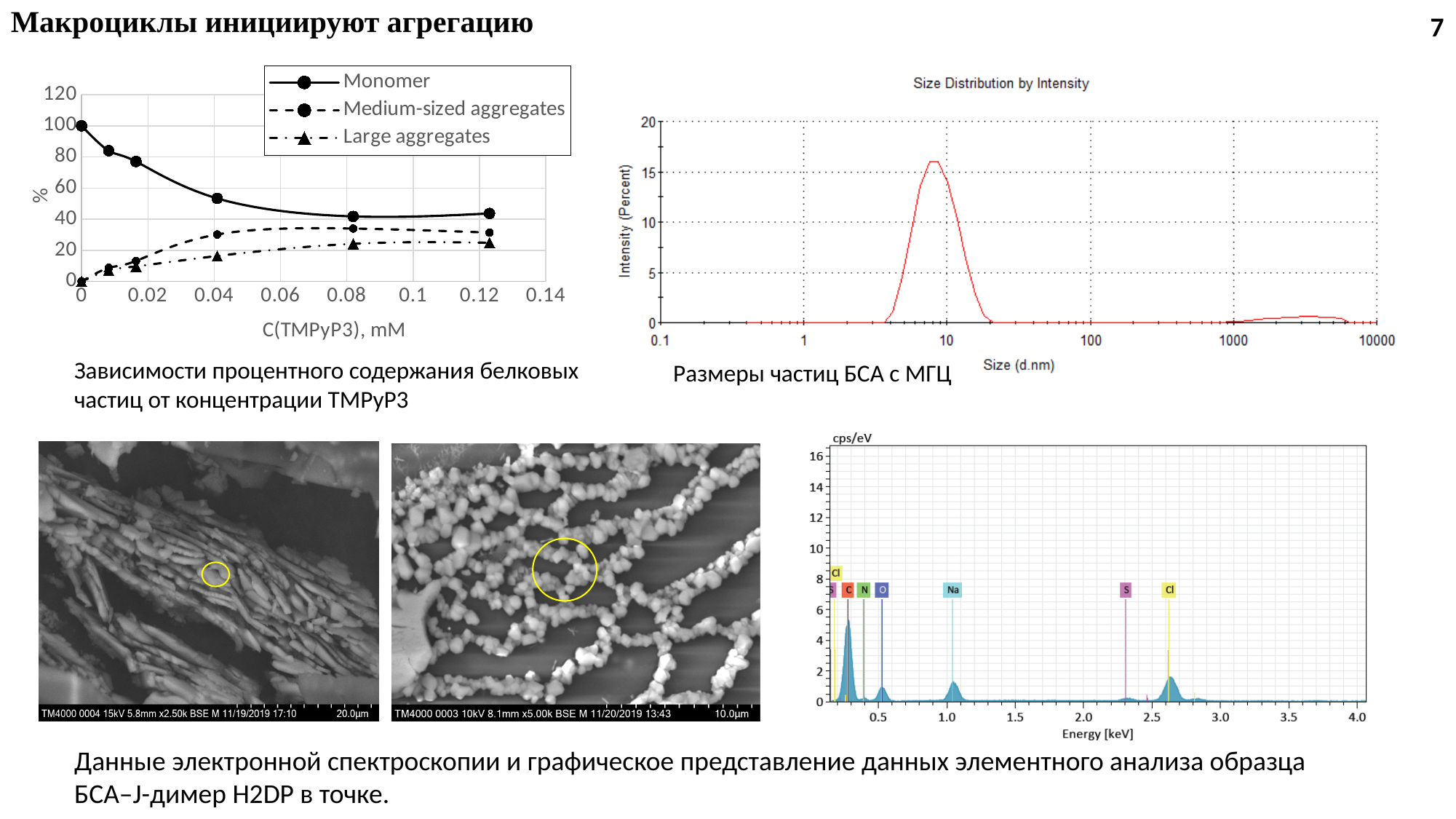
In the top-left chart, which series has the lowest value at 0.04 mM? Large aggregates In the top-left chart, does the Monomer series rise or fall as C(TMPyP3) increases from 0 to 0.08 mM? fall In the top-left chart, is the Large aggregates value at 0.04 mM greater or less than 20? less In the 'Size Distribution by Intensity' chart, is the height of the main peak greater or less than 20 percent? less In the top-left chart, does the Large aggregates series rise or fall as C(TMPyP3) increases from 0 to 0.08 mM? rise In the top-left chart, how many series does the legend list? 3 In the bottom-right spectrum chart (cps/eV vs Energy [keV]), is the tallest peak greater or less than 4 cps/eV? greater In the top-left chart, which series has the highest value at about 0.12 mM? Monomer What kind of chart is the top-left chart plotting Monomer, Medium-sized aggregates and Large aggregates? line chart In the top-left chart, what is the x-axis label? C(TMPyP3), mM